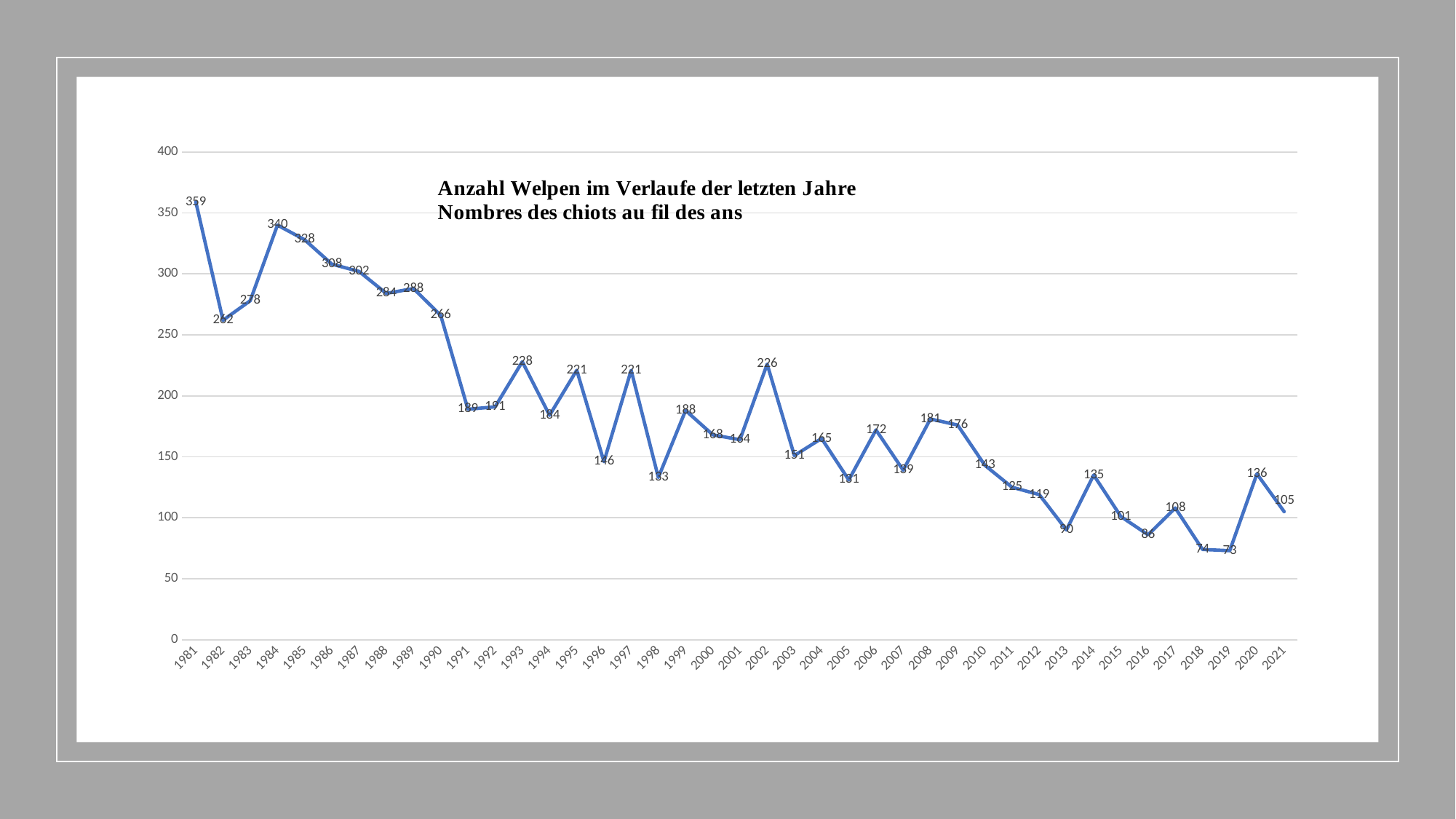
Which year has the highest value? 1981 How many years are plotted on the x axis? 41 Is the value for 1990 greater or less than 250? greater What is the value for 2021? 105 Which is larger, the value for 1984 or the value for 1985? 1984 What is the difference between the values for 1981 and 2021? 254 Do the values generally rise or fall from 1981 to 2021? fall What is the value for 2002? 226 What type of chart is shown on the slide? line chart What is the value for 1981? 359 What is the value for 2013? 90 Which year has the lowest value? 2019